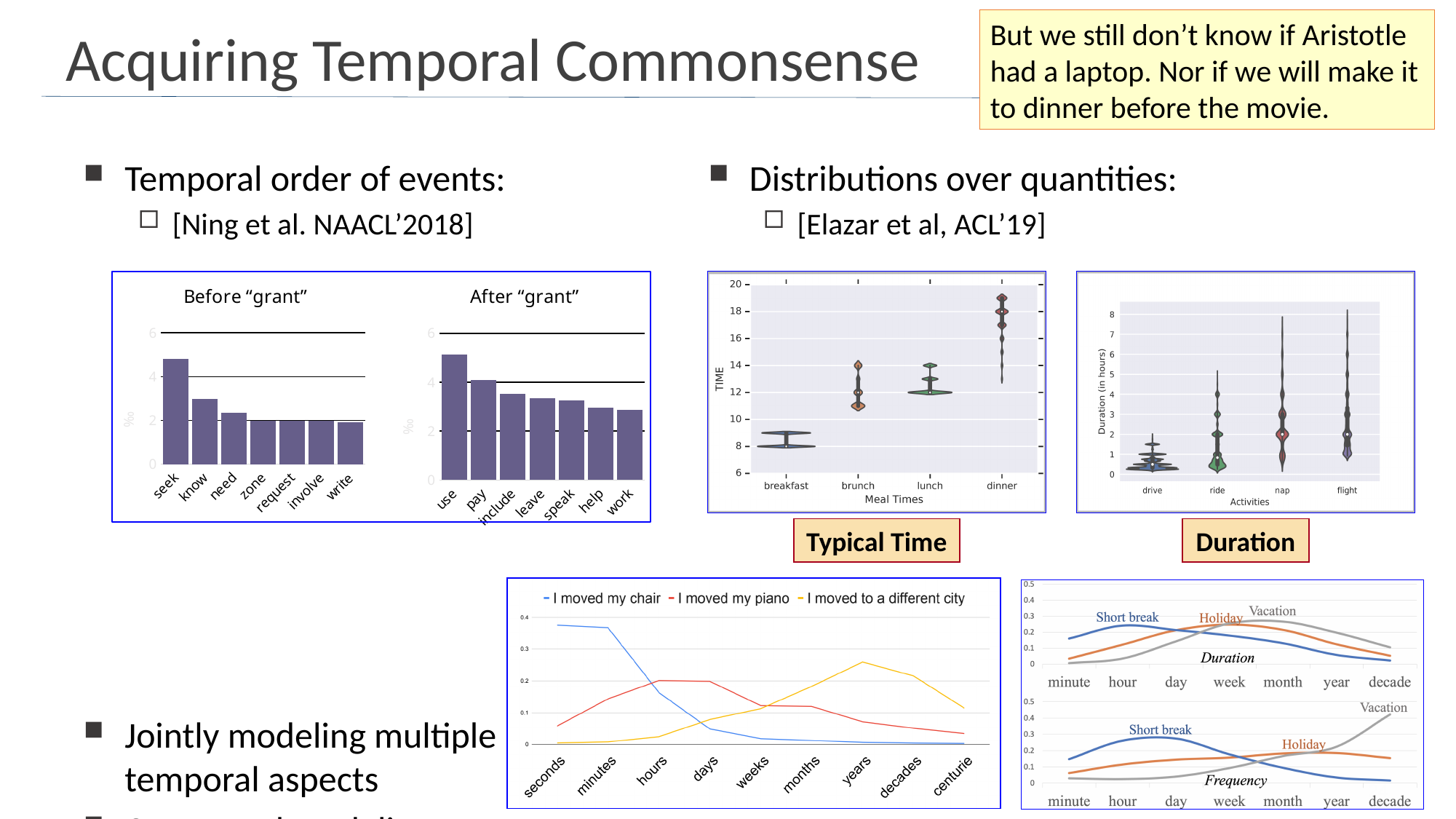
In the 'Before "grant"' chart, is the value for seek greater or less than 4? greater In the line chart with the legend 'I moved my chair', how many series does the legend list? 3 In the 'Duration' chart, what is the label of the x axis? Activities In the 'Typical Time' chart, which meal time has the highest typical time? dinner In the 'Before "grant"' bar chart, which category has the highest value? seek In the 'After "grant"' bar chart, which category has the highest value? use In the 'After "grant"' chart, is the value for work greater or less than 4? less How many categories are shown in the 'Before "grant"' bar chart? 7 In the 'Typical Time' chart, how many meal times are shown on the x axis? 4 What kind of chart is the 'After "grant"' chart? bar chart In the 'Typical Time' chart, is the typical time for breakfast greater or less than 10? less